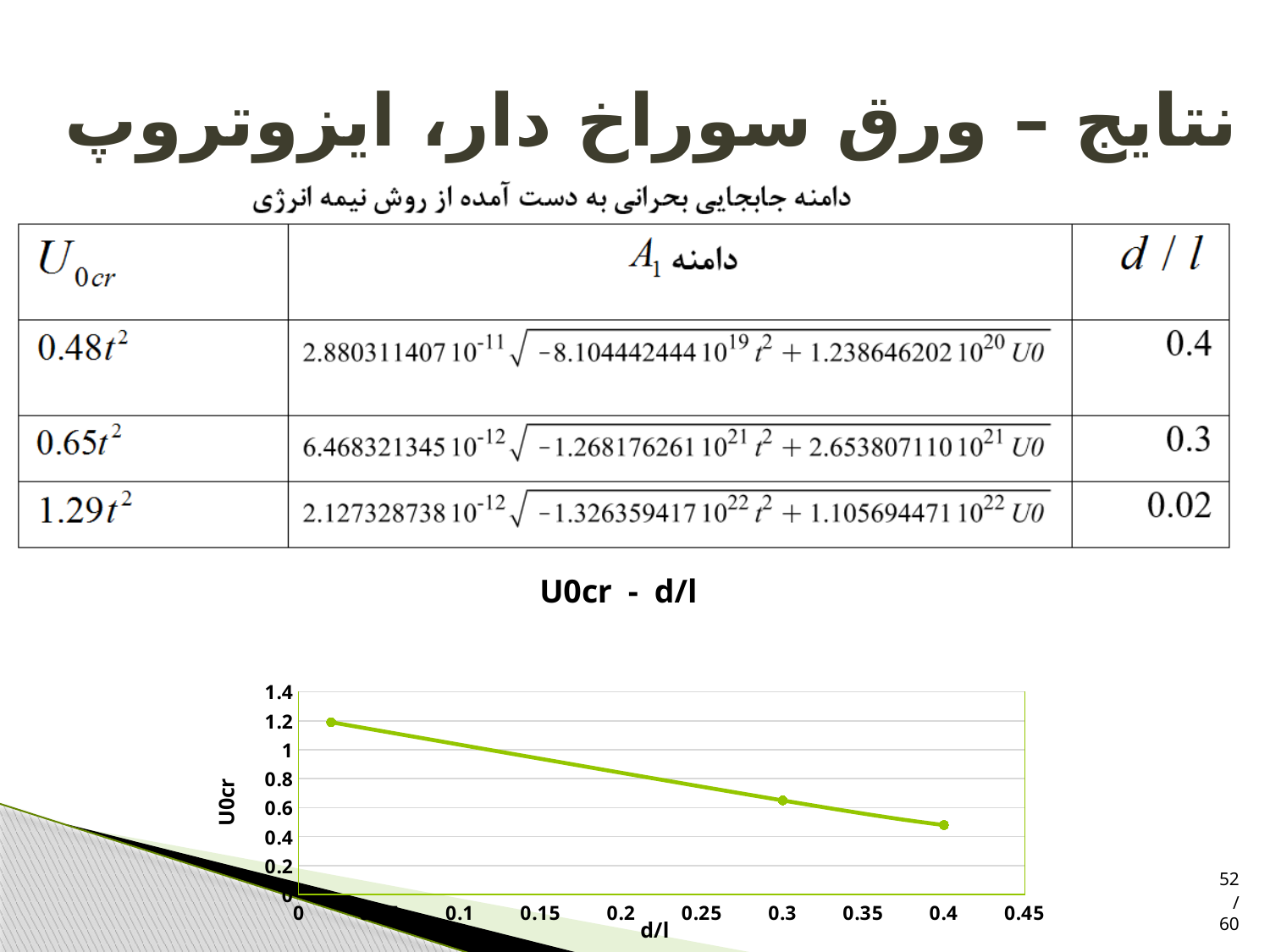
What is the title of the chart? U0cr - d/l What kind of chart is shown on the slide? line chart Is the value of U0cr at d/l = 0.4 greater or less than 0.4? greater Is the value of U0cr at d/l = 0.3 greater or less than 0.4? greater Does U0cr rise or fall as d/l increases along the x axis? fall Is the value of U0cr at the leftmost plotted point greater or less than 1? greater Which has the larger U0cr value: d/l = 0.3 or d/l = 0.4? d/l = 0.3 What is the label on the vertical axis of the chart? U0cr Does U0cr reach its highest value at the smallest or the largest d/l plotted? smallest How many data points are plotted on the U0cr - d/l chart? 3